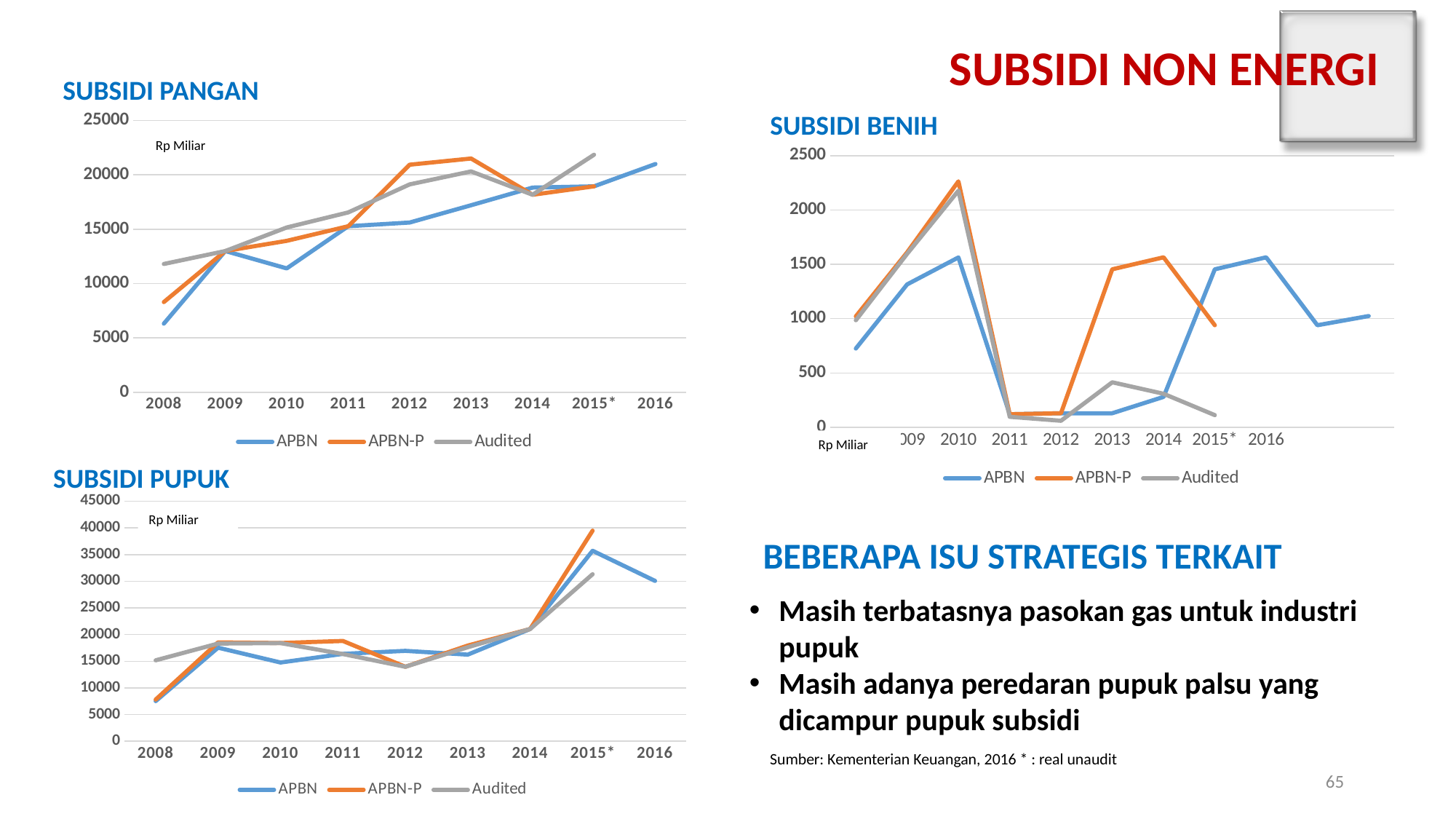
In the SUBSIDI PUPUK chart, is the APBN-P value for 2015* greater or less than 35000? greater In the SUBSIDI PANGAN chart, is the APBN value for 2016 greater or less than 20000? greater How many years are shown on the x axis of the SUBSIDI PANGAN chart? 9 In the SUBSIDI BENIH chart, which year has the highest APBN-P value? 2010 In the SUBSIDI PUPUK chart, which year has the highest APBN-P value? 2015* In the SUBSIDI PUPUK chart, is the APBN value for 2008 greater or less than 10000? less What unit is stated on the SUBSIDI BENIH chart? Rp Miliar In the SUBSIDI PANGAN chart, does the APBN series rise or fall overall from 2008 to 2016? rise What kind of chart is the SUBSIDI PANGAN chart? line chart How many series does the legend of the SUBSIDI PUPUK chart list? 3 In the SUBSIDI BENIH chart, which is larger in 2010, the APBN value or the APBN-P value? APBN-P